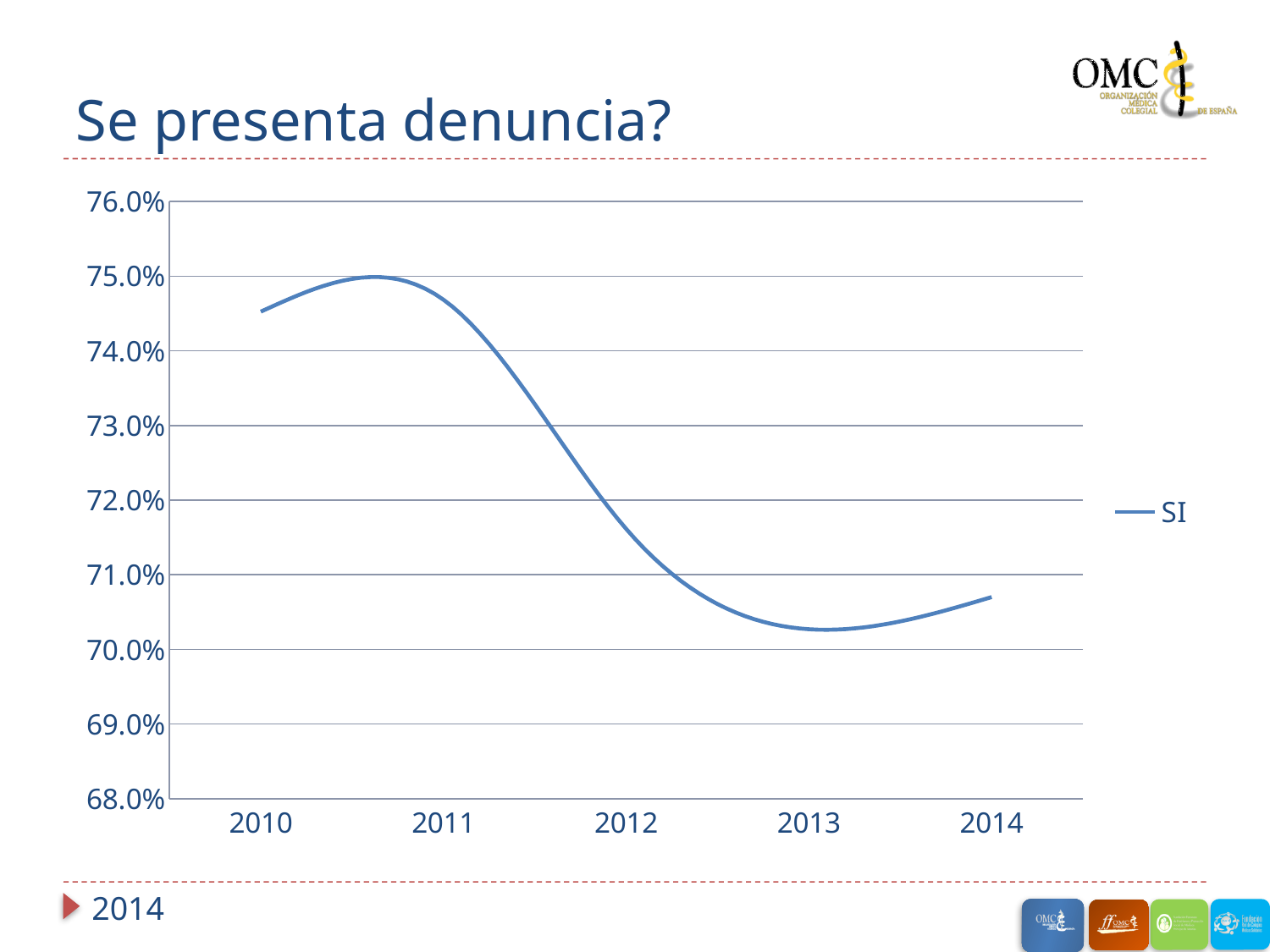
How many years are plotted on the x axis? 5 Overall, does the value for SI rise or fall from 2010 to 2014? fall How many series does the legend list? 1 Is the value for SI in 2010 greater or less than 74.0%? greater Which year has the lowest value for SI? 2013 What is the title of the chart? Se presenta denuncia? Which is larger, the value for SI in 2010 or in 2013? 2010 Is the value for SI in 2013 greater or less than 71.0%? less Is the value for SI in 2014 greater or less than 71.0%? less What is the name of the series shown in the legend? SI What kind of chart is shown on the slide? line chart